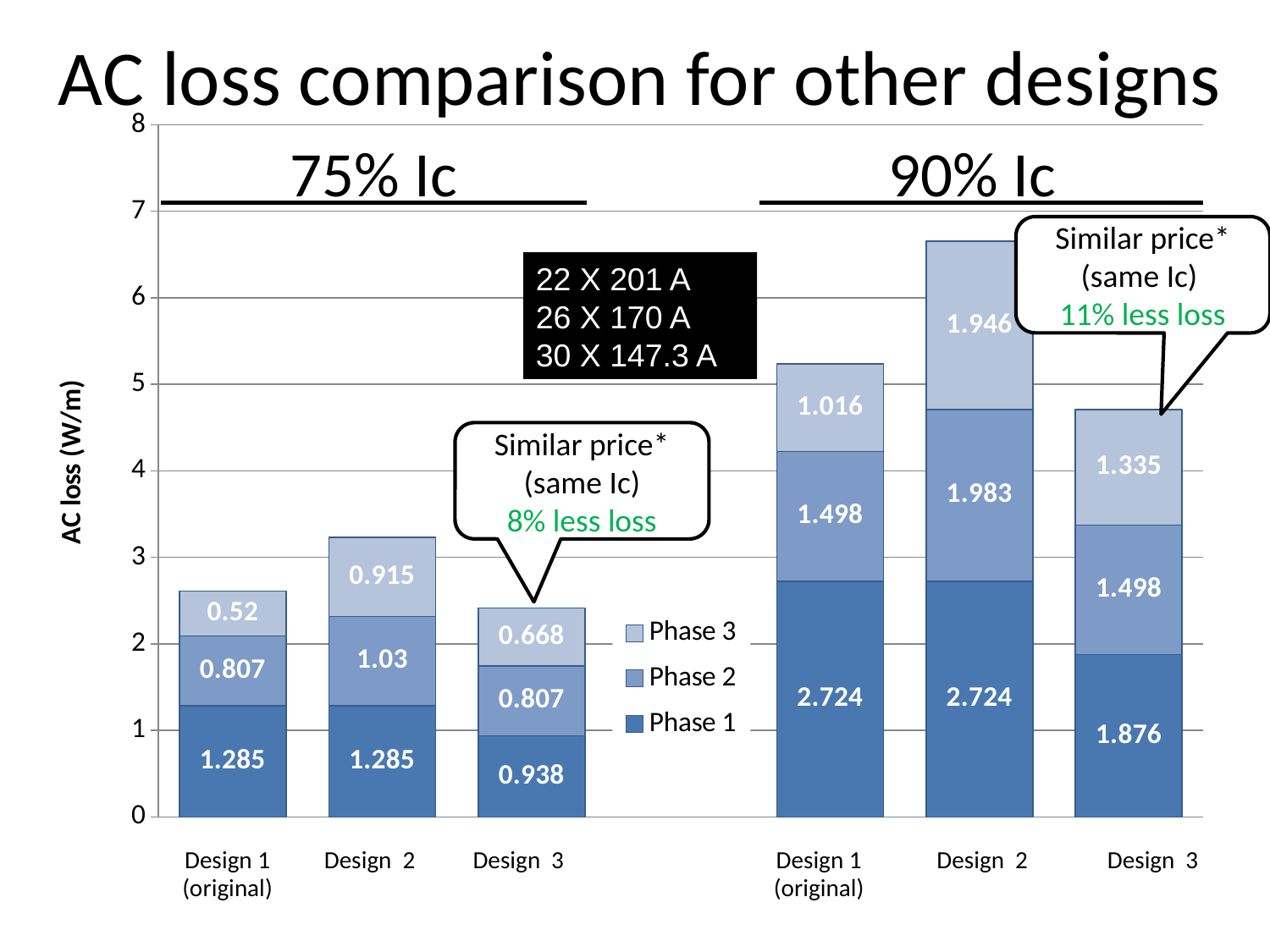
Is the total AC loss for Design 2 at 90% Ic greater or less than 6? greater What kind of chart is shown on the slide? Stacked bar chart What is the Phase 2 value for Design 1 (original) at 90% Ic? 1.498 What is the Phase 3 value for Design 2 at 90% Ic? 1.946 What is the Phase 1 value for Design 3 at 75% Ic? 0.938 What is the total AC loss for Design 1 (original) at 75% Ic? 2.612 Which is larger: the Phase 3 value for Design 2 at 75% Ic or the Phase 3 value for Design 3 at 75% Ic? Design 2 at 75% Ic How many bars are plotted in the chart? 6 How many series does the legend list? 3 What is the difference between the Phase 1 values of Design 1 (original) and Design 3 at 90% Ic? 0.848 Which bar has the highest total AC loss? Design 2 at 90% Ic Which bar has the lowest total AC loss? Design 3 at 75% Ic